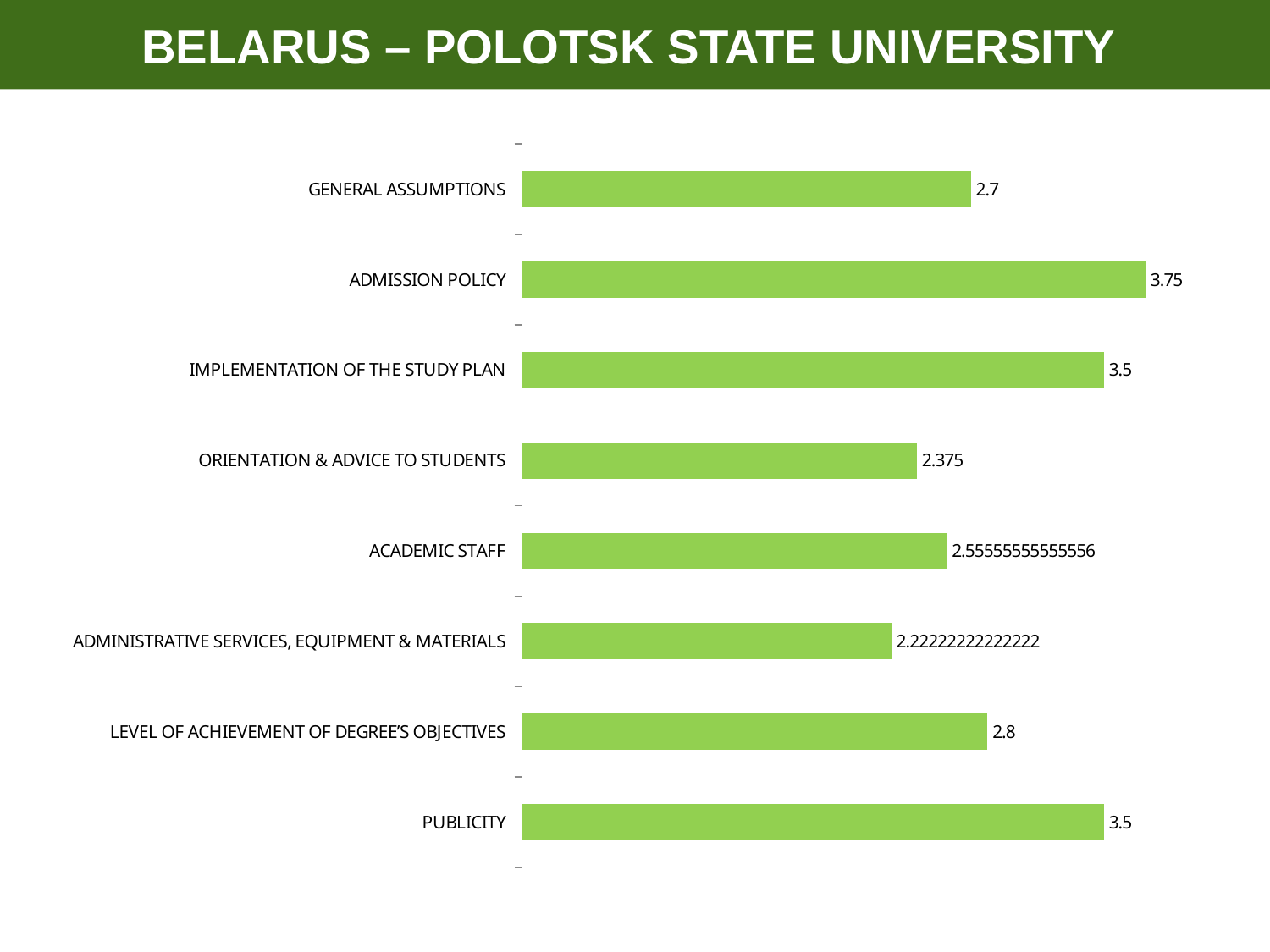
What is the value for ADMISSION POLICY? 3.75 What is the value for PUBLICITY? 3.5 What is the value for LEVEL OF ACHIEVEMENT OF DEGREE'S OBJECTIVES? 2.8 Which category has the lowest value? ADMINISTRATIVE SERVICES, EQUIPMENT & MATERIALS Which is larger, the value for PUBLICITY or the value for GENERAL ASSUMPTIONS? PUBLICITY What kind of chart is shown on the slide? Bar chart What is the difference between the values for ADMISSION POLICY and GENERAL ASSUMPTIONS? 1.05 Which category has the highest value? ADMISSION POLICY How many categories are shown in the chart? 8 What is the difference between the values for IMPLEMENTATION OF THE STUDY PLAN and ORIENTATION & ADVICE TO STUDENTS? 1.125 What is the value for ACADEMIC STAFF? 2.55555555555556 What is the value for ORIENTATION & ADVICE TO STUDENTS? 2.375